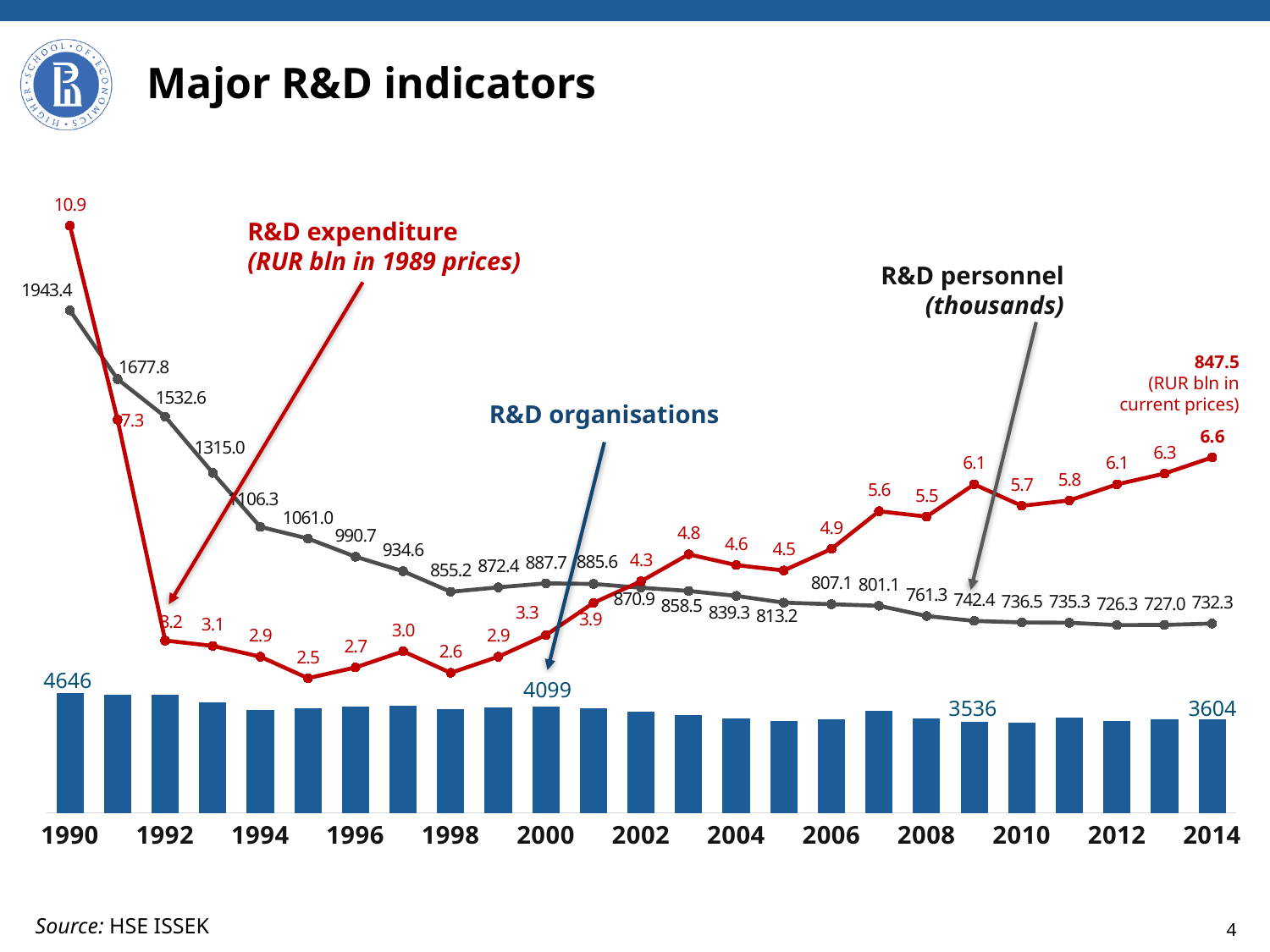
In which year is R&D personnel (thousands) at its highest? 1990 What is the R&D personnel value (thousands) in 2014? 732.3 Which year has the higher R&D expenditure (RUR bln in 1989 prices), 2009 or 2010? 2009 Does R&D personnel (thousands) rise or fall overall from 1990 to 2014? fall How many R&D organisations are shown for 1990? 4646 By how much did R&D personnel (thousands) fall from 1990 to 2014? 1211.1 What is the R&D expenditure (RUR bln in 1989 prices) in 1990? 10.9 In which year is R&D expenditure (RUR bln in 1989 prices) at its lowest? 1995 What is the difference between the number of R&D organisations in 1990 and in 2014? 1042 What is the 2014 R&D expenditure in RUR bln in current prices, as noted on the slide? 847.5 How many R&D organisations are shown for 2009? 3536